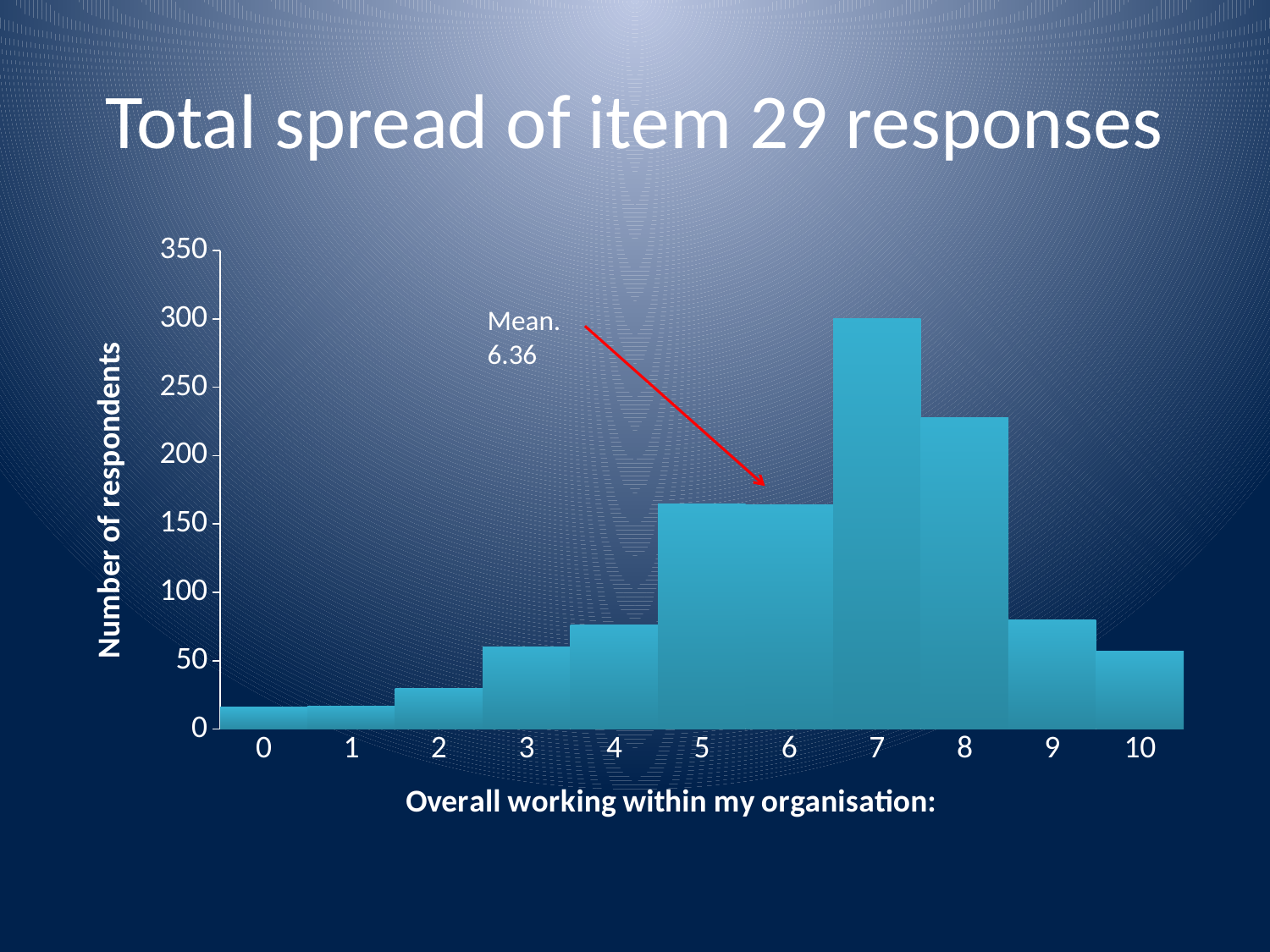
Is the number of respondents for response 5 greater or less than 150? greater Is the number of respondents for response 8 greater or less than 200? greater Is the number of respondents for response 3 greater or less than 100? less Which response value has the highest number of respondents? 7 What is the label of the y axis? Number of respondents What mean value is annotated on the chart? 6.36 Which has more respondents, response 4 or response 5? 5 How many response categories are shown along the x axis? 11 Which has more respondents, response 8 or response 9? 8 What kind of chart is shown on the slide? bar chart